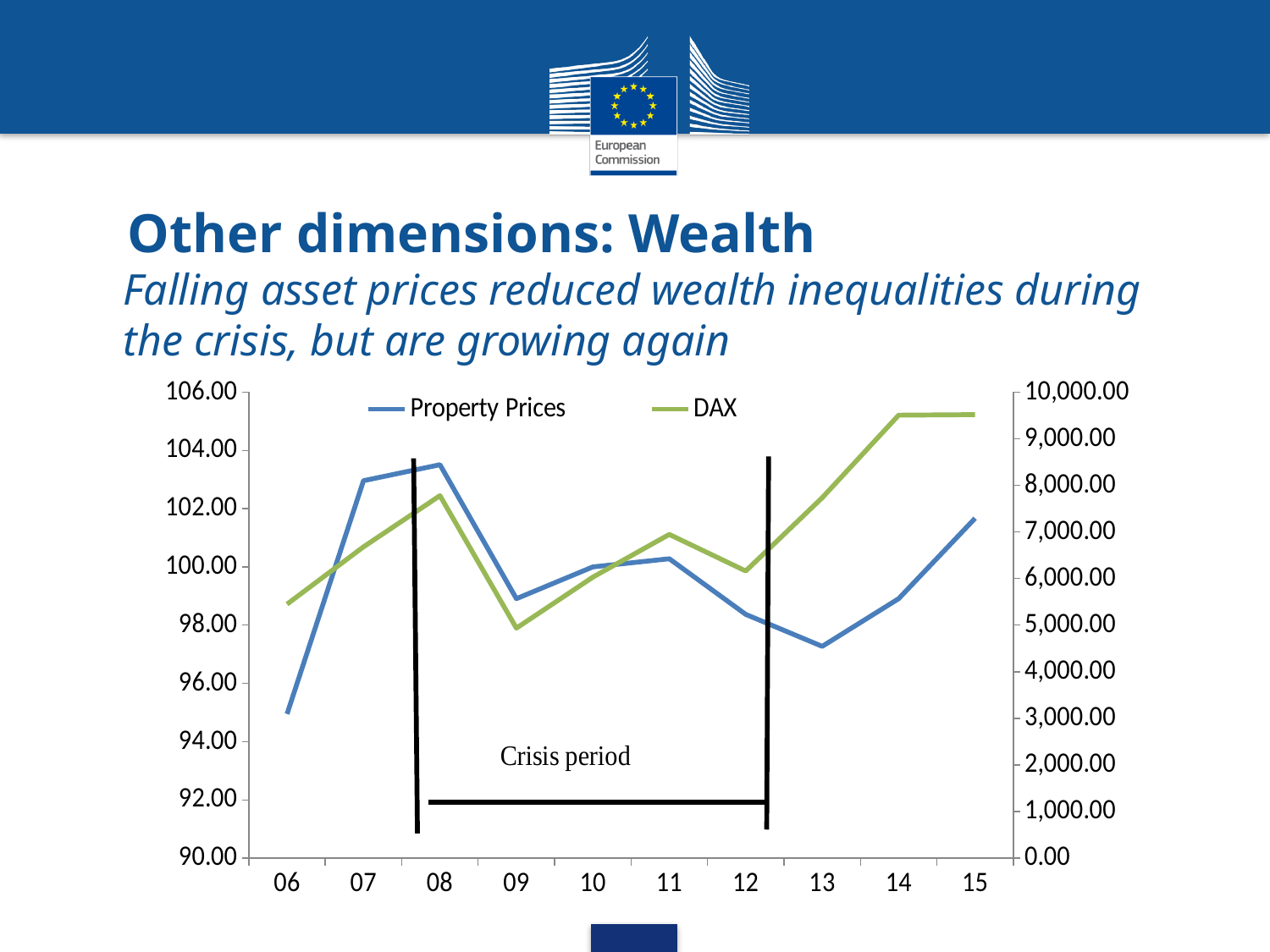
Does the Property Prices series rise or fall from 13 to 15? rise In which year is the Property Prices series at its lowest? 06 In which year is the DAX series at its lowest? 09 Which is larger, the Property Prices value for 07 or for 13? 07 What label is written between the two vertical black lines on the chart? Crisis period Does the DAX series rise or fall from 08 to 09? fall Is the DAX value for 14 greater or less than 9,000.00? greater What kind of chart is shown on the slide? line chart How many series does the chart's legend list? 2 Is the Property Prices value for 06 greater or less than 96.00? less Is the DAX value for 08 greater or less than 7,000.00? greater How many years are plotted along the x axis of the chart? 10